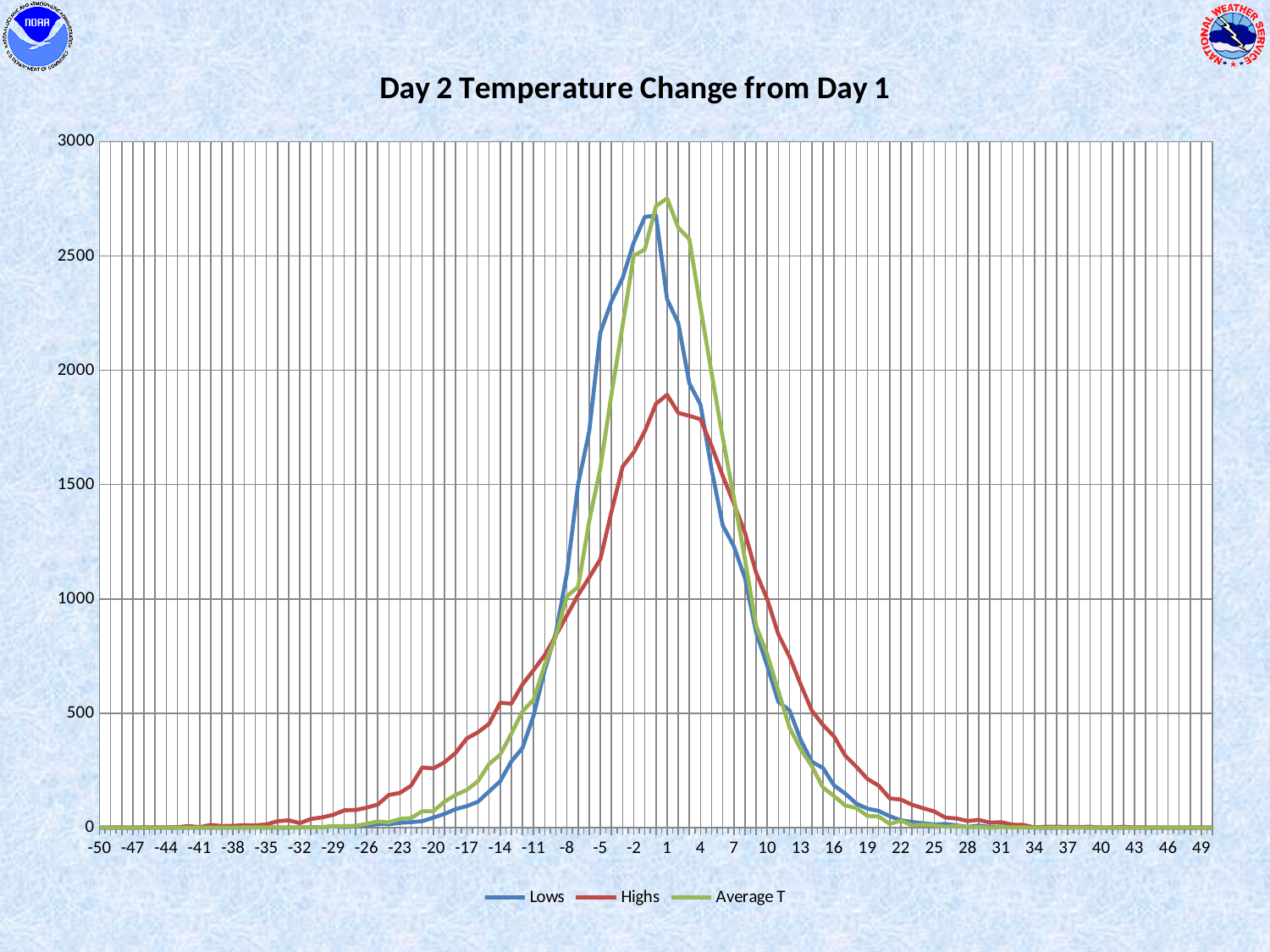
Is the peak value of the Highs series greater or less than 2000? less Is the value of the Lows series at -5 greater or less than 2000? greater What is the title of the chart? Day 2 Temperature Change from Day 1 What kind of chart is shown on the slide? Line chart Do the values of the Lows series rise or fall along the x axis from 4 to 49? fall Which series has the lowest peak value? Highs At -20, which series has the larger value, Highs or Lows? Highs Is the peak value of the Average T series greater or less than 2500? greater At -5, which series has the larger value, Lows or Highs? Lows Which series is drawn in red? Highs How many series does the legend list? 3